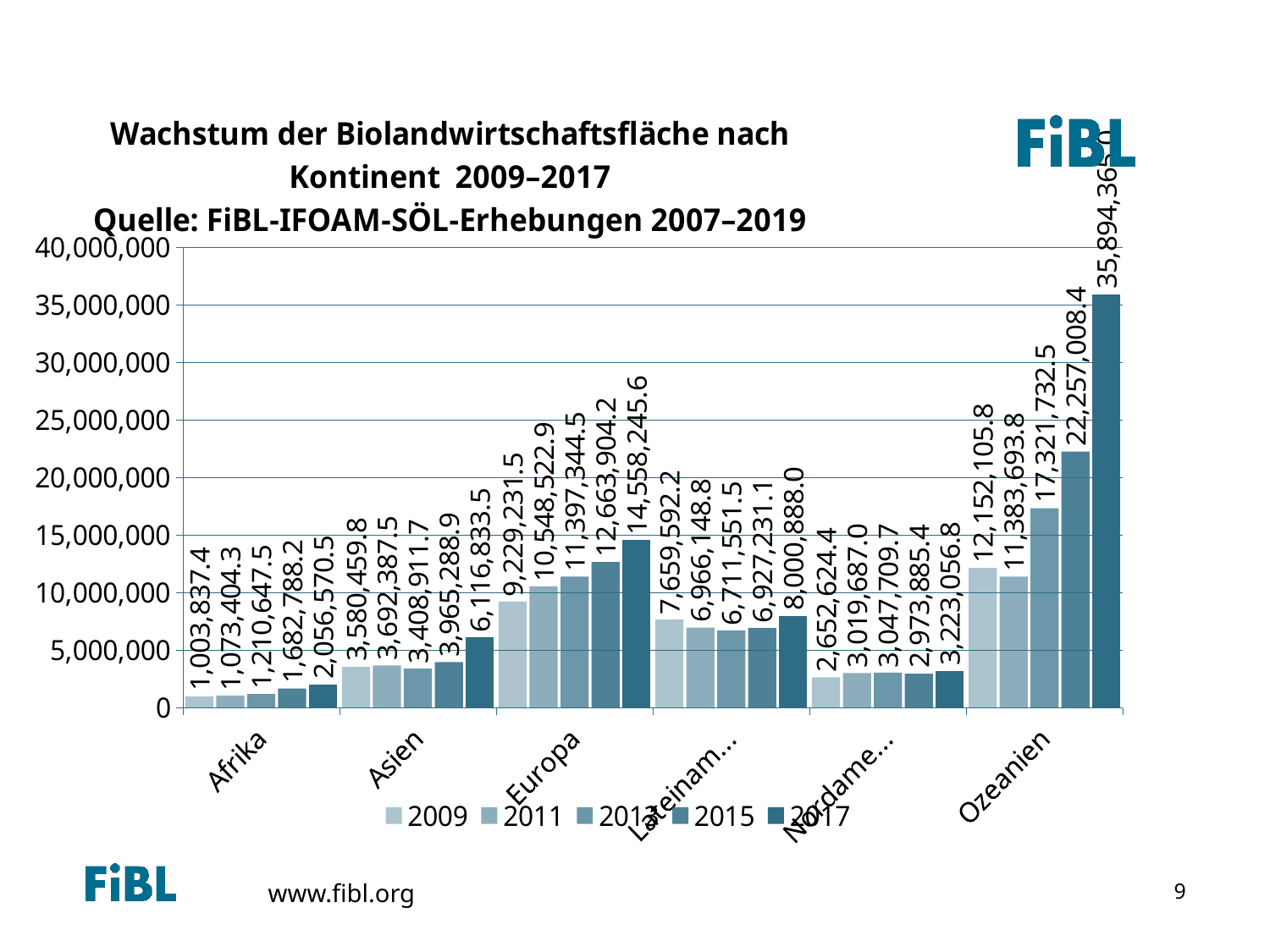
Which continent has the lowest value in 2009? Afrika Do the values for Europa rise or fall from 2009 to 2017? rise Which continent has the highest value in 2017? Ozeanien What is the value for Asien in 2013? 3,408,911.7 What kind of chart is shown on the slide? bar chart How many years (series) does the legend list? 5 By how much did the value for Europa increase from 2009 to 2017? 5,329,014.1 Which is larger in 2017: the value for Asien or the value for Europa? Europa Is the value for Ozeanien in 2017 greater or less than 30,000,000? greater What is the value for Afrika in 2009? 1,003,837.4 What is the value for Europa in 2017? 14,558,245.6 How many continent categories are shown on the x axis? 6